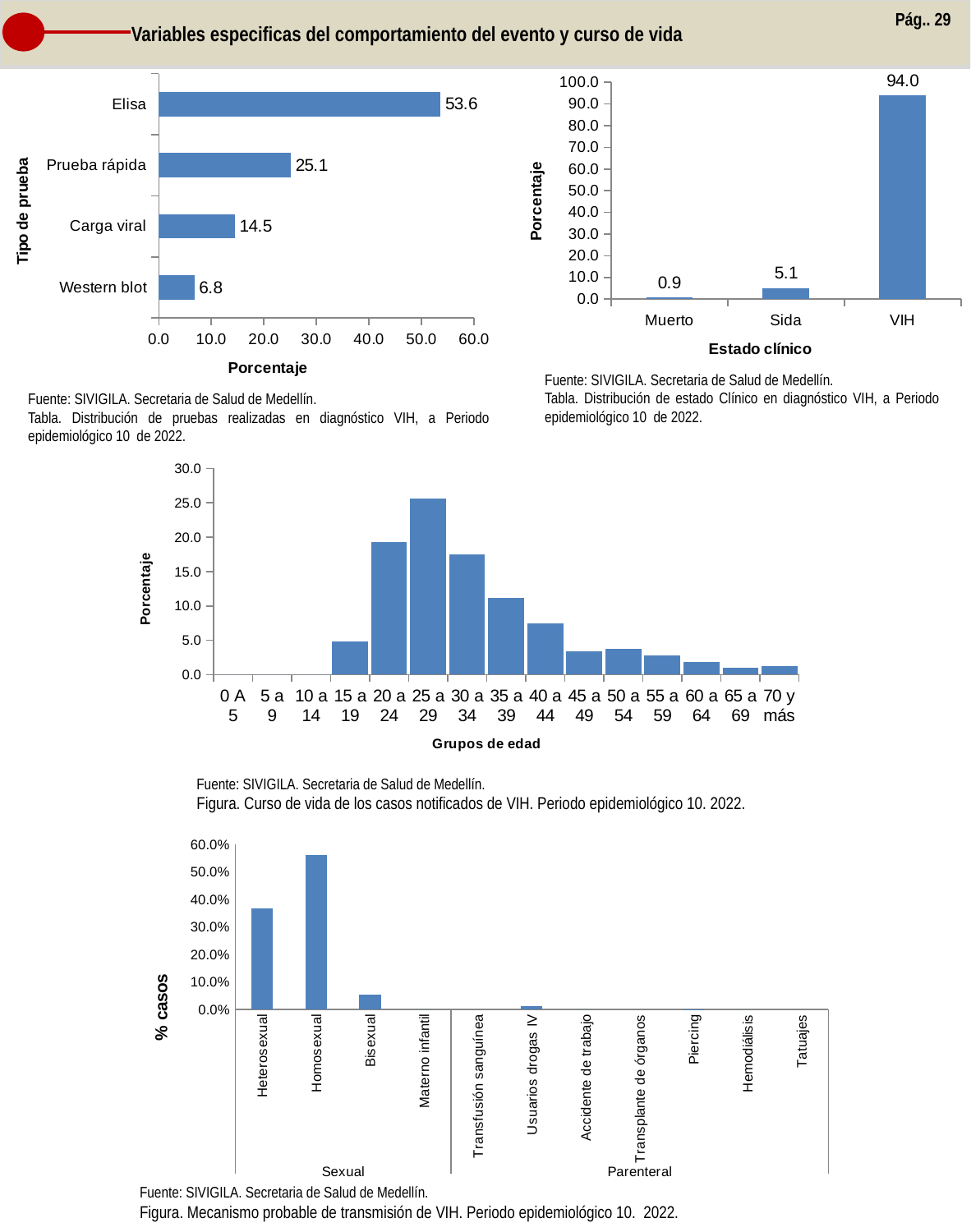
In the top-right chart (Estado clínico), what is the value for Sida? 5.1 In the middle chart (Grupos de edad), which age group has the highest value? 25 a 29 In the top-right chart (Estado clínico), which clinical state has the highest value? VIH In the top-left chart (Tipo de prueba), what is the value for Elisa? 53.6 In the bottom chart (Mecanismo probable de transmisión), is the value for Heterosexual greater or less than 40.0%? less In the top-left chart (Tipo de prueba), which is larger: Carga viral or Prueba rápida? Prueba rápida What kind of chart is the top-left chart (Tipo de prueba)? Bar chart How many age groups are shown on the x axis of the middle chart (Grupos de edad)? 15 In the top-left chart (Tipo de prueba), which test type has the lowest value? Western blot In the top-right chart (Estado clínico), what is the difference between the values for VIH and Sida? 88.9 In the top-left chart (Tipo de prueba), what is the difference between the values for Elisa and Prueba rápida? 28.5 In the middle chart (Grupos de edad), is the value for 25 a 29 greater or less than 20.0? greater